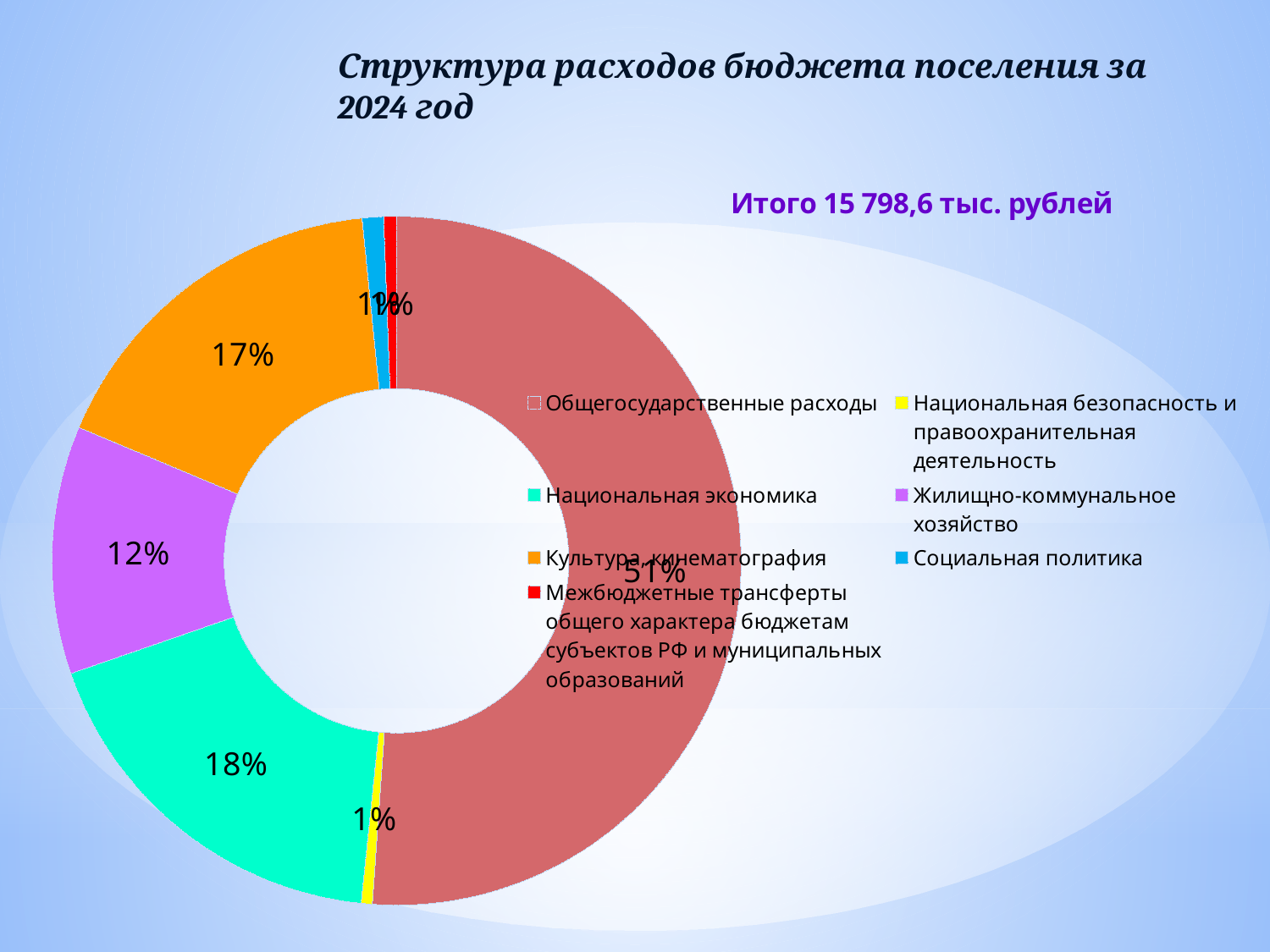
What kind of chart is shown on the slide? Doughnut (pie) chart Which is larger, Национальная экономика or Культура, кинематография? Национальная экономика How many categories does the legend list? 7 What percentage is shown for Жилищно-коммунальное хозяйство? 12% What percentage is shown for Национальная безопасность и правоохранительная деятельность? 1% What is the difference in percentage points between Общегосударственные расходы and Национальная экономика? 33 What percentage is shown for Национальная экономика? 18% Which category has the largest share of the chart? Общегосударственные расходы What percentage is shown for Культура, кинематография? 17% What total amount is stated on the slide? 15 798,6 тыс. рублей What is the title of the chart? Итого 15 798,6 тыс. рублей What share of the chart does Общегосударственные расходы take? 51%